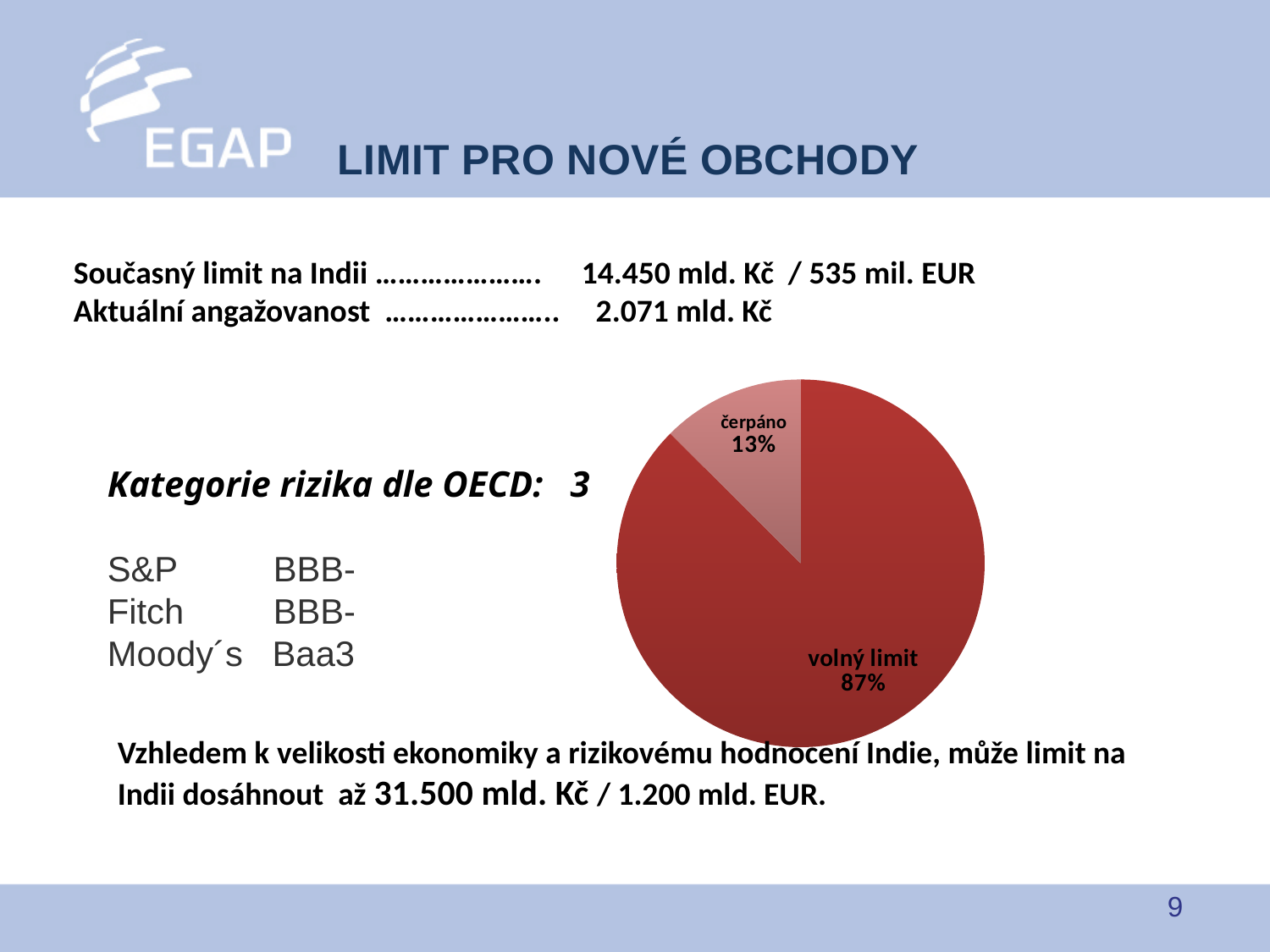
Which slice of the pie chart is shown in a lighter shade of red? čerpáno What is the total of the two slices shown in the pie chart? 100% What is the difference in percentage points between the "volný limit" and "čerpáno" slices? 74 What share of the pie does the "čerpáno" slice represent? 13% Which is larger, the "čerpáno" slice or the "volný limit" slice? volný limit What colour is the "volný limit" slice of the pie chart? dark red What kind of chart is shown on the slide? pie chart How many slices does the pie chart have? 2 Which slice of the pie chart is the largest? volný limit Which slice of the pie chart is the smallest? čerpáno What share of the pie does the "volný limit" slice represent? 87%